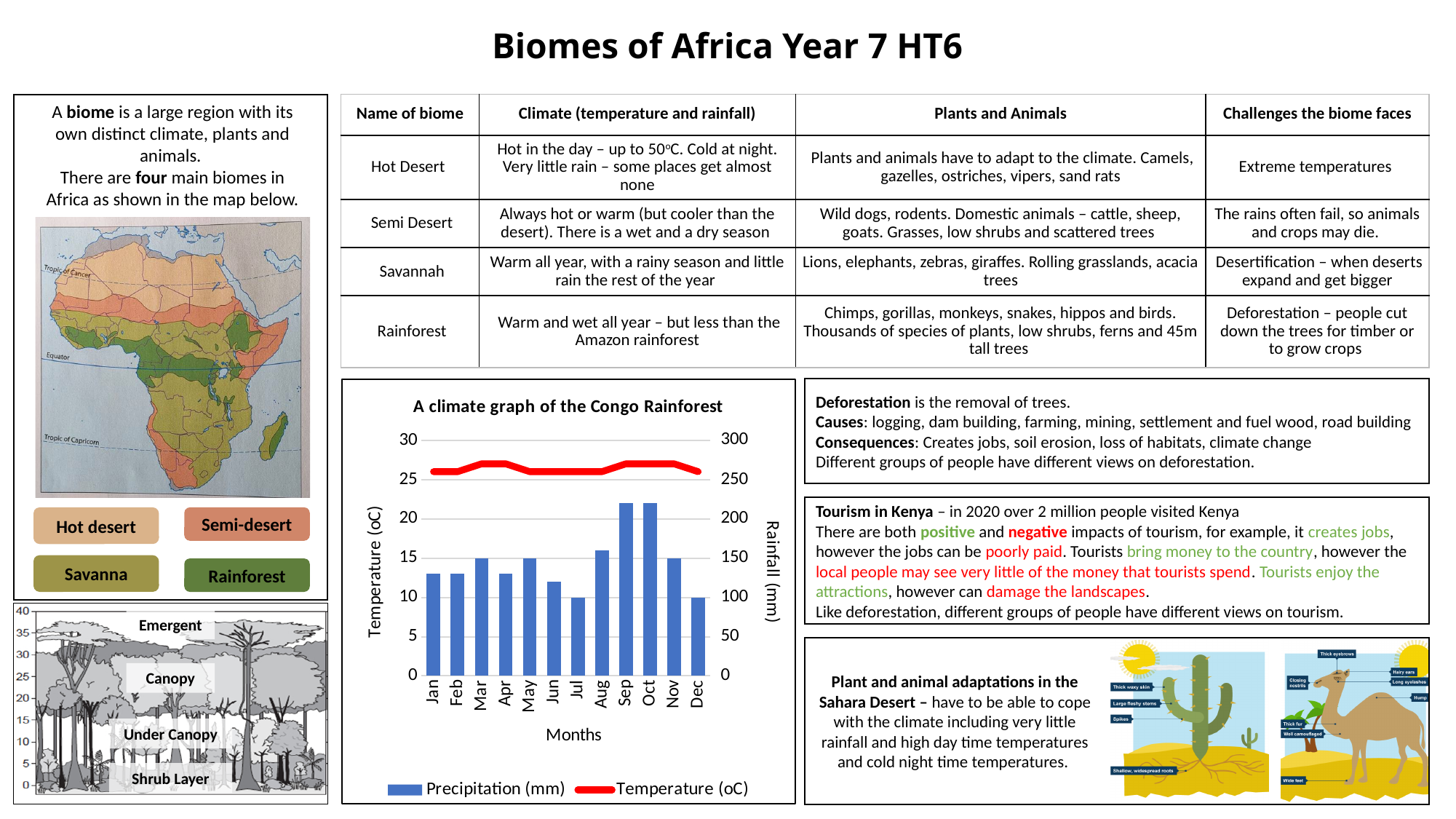
How many series does the legend of the climate graph list? 2 What is the title of the chart on the slide? A climate graph of the Congo Rainforest In the climate graph, is the precipitation for Aug greater or less than 150 mm? greater How many months are plotted along the x axis of the climate graph? 12 In the climate graph, is the precipitation for Jan greater or less than 150 mm? less In the climate graph, is the precipitation for Sep greater or less than 200 mm? greater In the climate graph, which month has the higher precipitation, Sep or Jan? Sep In the climate graph, which series is shown as blue bars? Precipitation (mm) What is the label on the right-hand vertical axis of the climate graph? Rainfall (mm) In the climate graph, which month has the higher precipitation, Jul or Aug? Aug